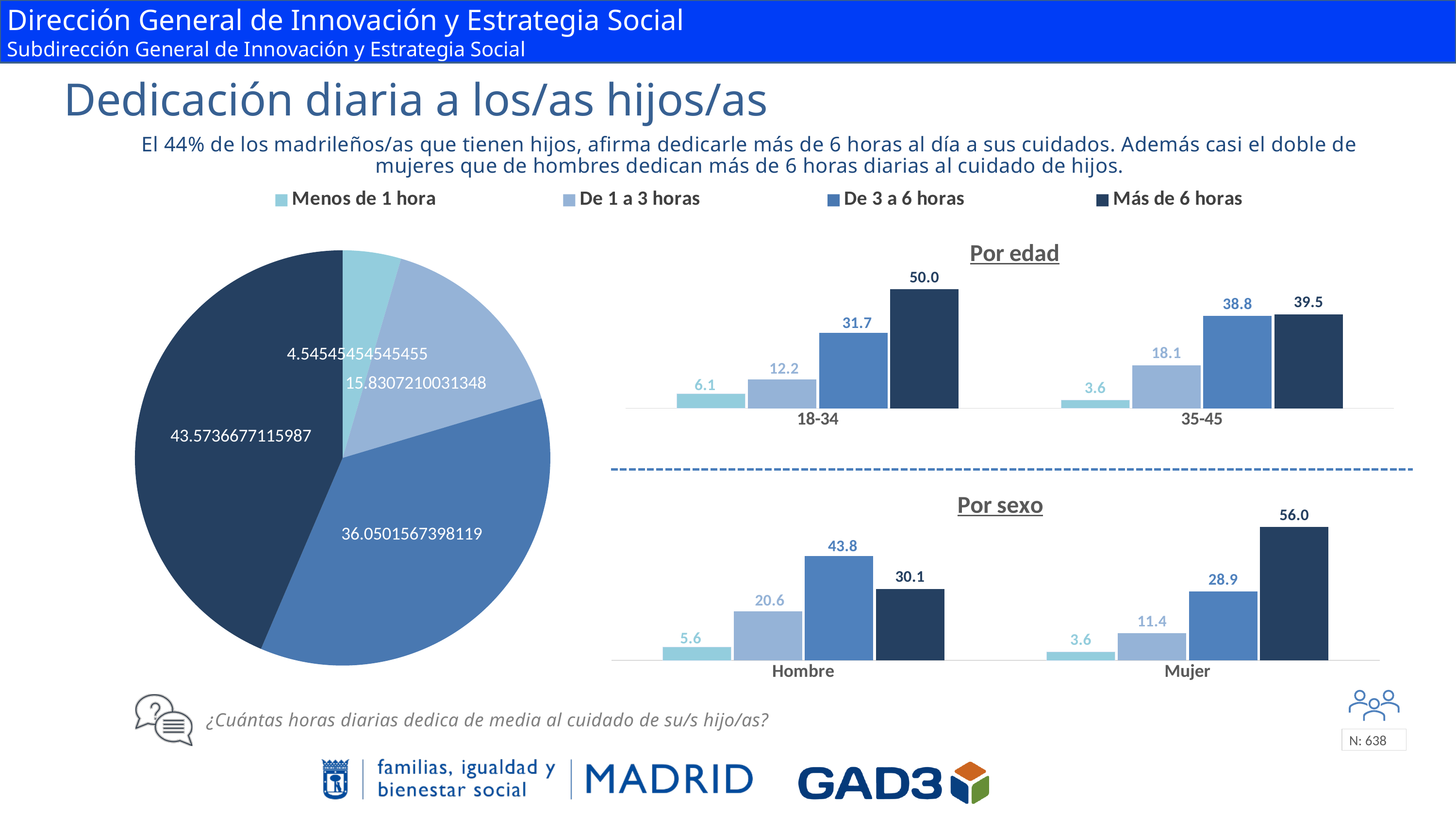
In the 'Por sexo' chart, what is the value for 'De 3 a 6 horas' for Hombre? 43.8 How many series does the legend list? 4 What kind of chart is the chart on the left of the slide? Pie chart In the 'Por edad' chart, which category has the highest value in the 18-34 group? Más de 6 horas In the 'Por sexo' chart, what is the value for 'Más de 6 horas' for Mujer? 56.0 In the pie chart on the left, what is the value shown for the 'Más de 6 horas' slice? 43.5736677115987 In the 'Por edad' chart, which is larger: 'De 3 a 6 horas' for 18-34 or 'De 3 a 6 horas' for 35-45? 35-45 In the 'Por sexo' chart, which is larger for Hombre: 'De 3 a 6 horas' or 'Más de 6 horas'? De 3 a 6 horas In the 'Por sexo' chart, which category has the lowest value for Mujer? Menos de 1 hora In the 'Por edad' chart, what is the value for 'De 1 a 3 horas' in the 35-45 group? 18.1 In the 'Por sexo' chart, what is the difference between the 'Más de 6 horas' values for Mujer and Hombre? 25.9 In the 'Por edad' chart, what is the value for 'Más de 6 horas' in the 18-34 group? 50.0